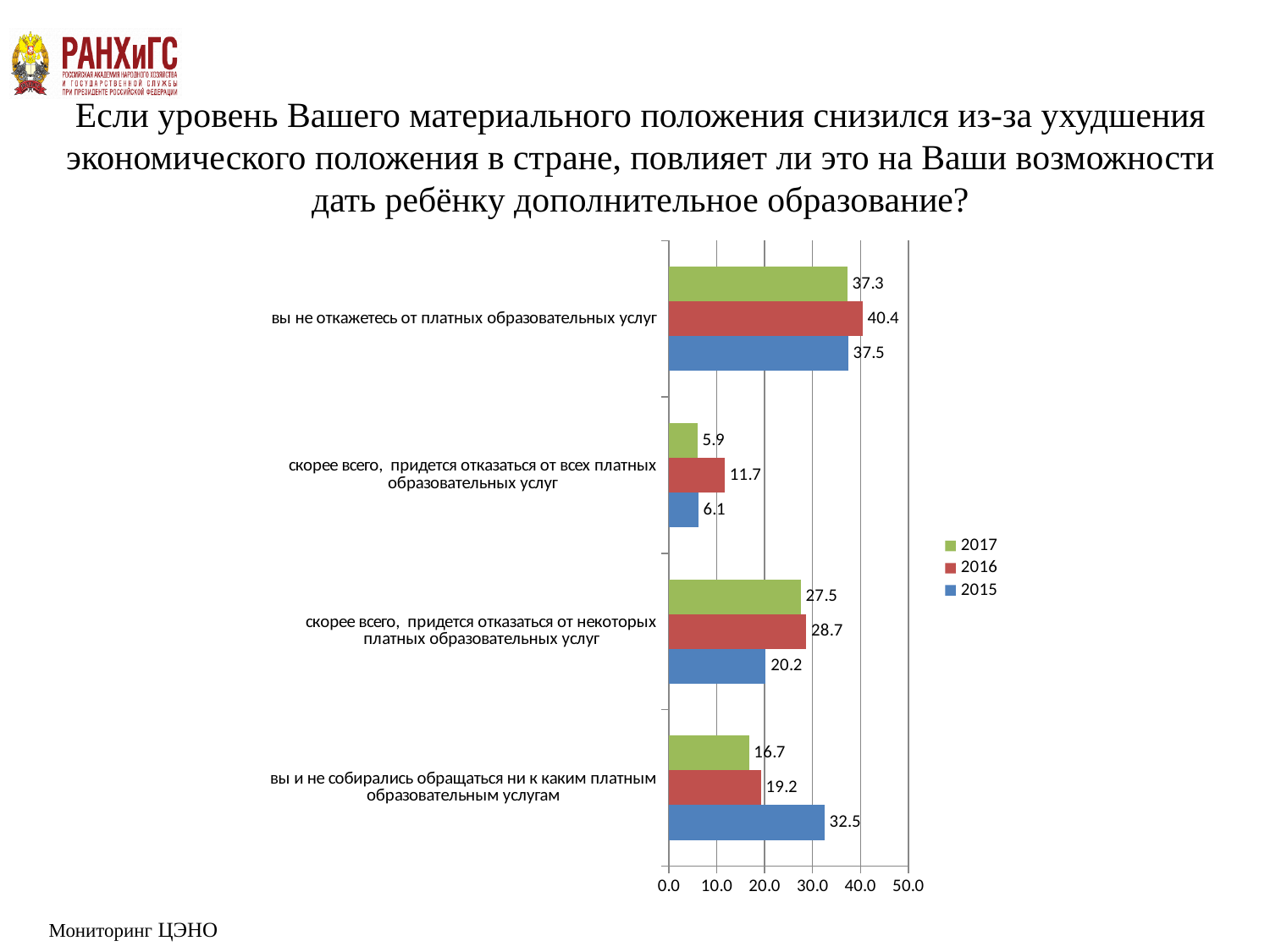
What kind of chart is shown on the slide? bar chart What is the 2016 value for "вы не откажетесь от платных образовательных услуг"? 40.4 Which category has the highest 2017 value? вы не откажетесь от платных образовательных услуг What is the difference between the 2015 and 2017 values for "вы и не собирались обращаться ни к каким платным образовательным услугам"? 15.8 Which category has the lowest 2015 value? скорее всего, придется отказаться от всех платных образовательных услуг What is the 2017 value for "скорее всего, придется отказаться от всех платных образовательных услуг"? 5.9 What is the 2015 value for "скорее всего, придется отказаться от некоторых платных образовательных услуг"? 20.2 How many categories are shown on the chart? 4 What is the 2015 value for "вы и не собирались обращаться ни к каким платным образовательным услугам"? 32.5 Is the 2016 value for "вы не откажетесь от платных образовательных услуг" greater or less than 40.0? greater For "скорее всего, придется отказаться от всех платных образовательных услуг", which year has the larger value, 2016 or 2017? 2016 How many series does the legend list? 3